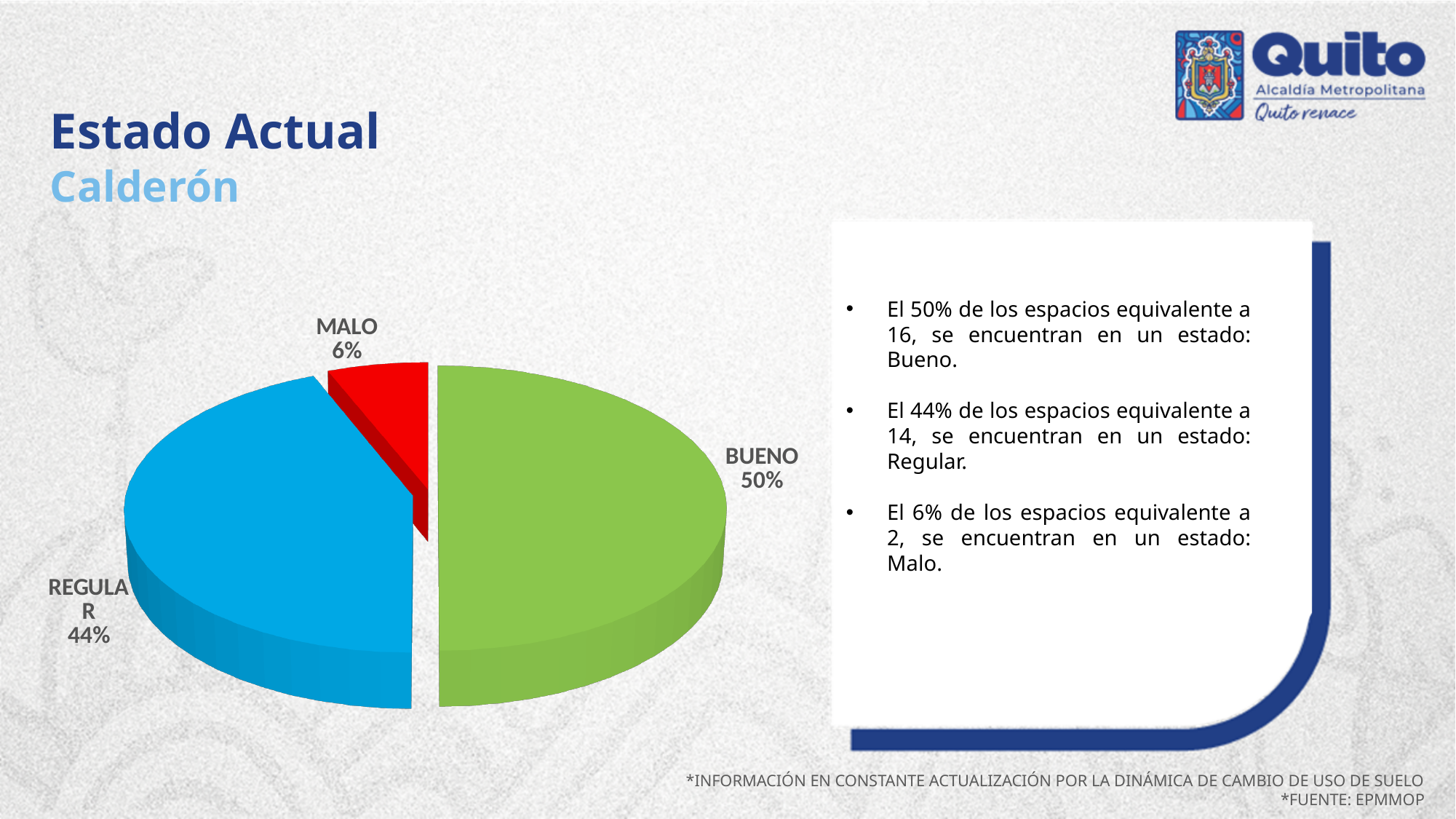
What percentage of the pie chart is labelled MALO? 6% What is the difference in percentage points between the REGULAR and MALO slices? 38 What percentage of the pie chart is labelled BUENO? 50% What is the difference in percentage points between the BUENO and REGULAR slices? 6 How many slices does the pie chart have? 3 Which slice is larger, REGULAR or MALO? REGULAR What colour is the MALO slice of the pie chart? Red Which category has the largest share of the pie chart? BUENO What percentage of the pie chart is labelled REGULAR? 44% What kind of chart is shown on the slide? Pie chart What colour is the BUENO slice of the pie chart? Green Which category has the smallest share of the pie chart? MALO